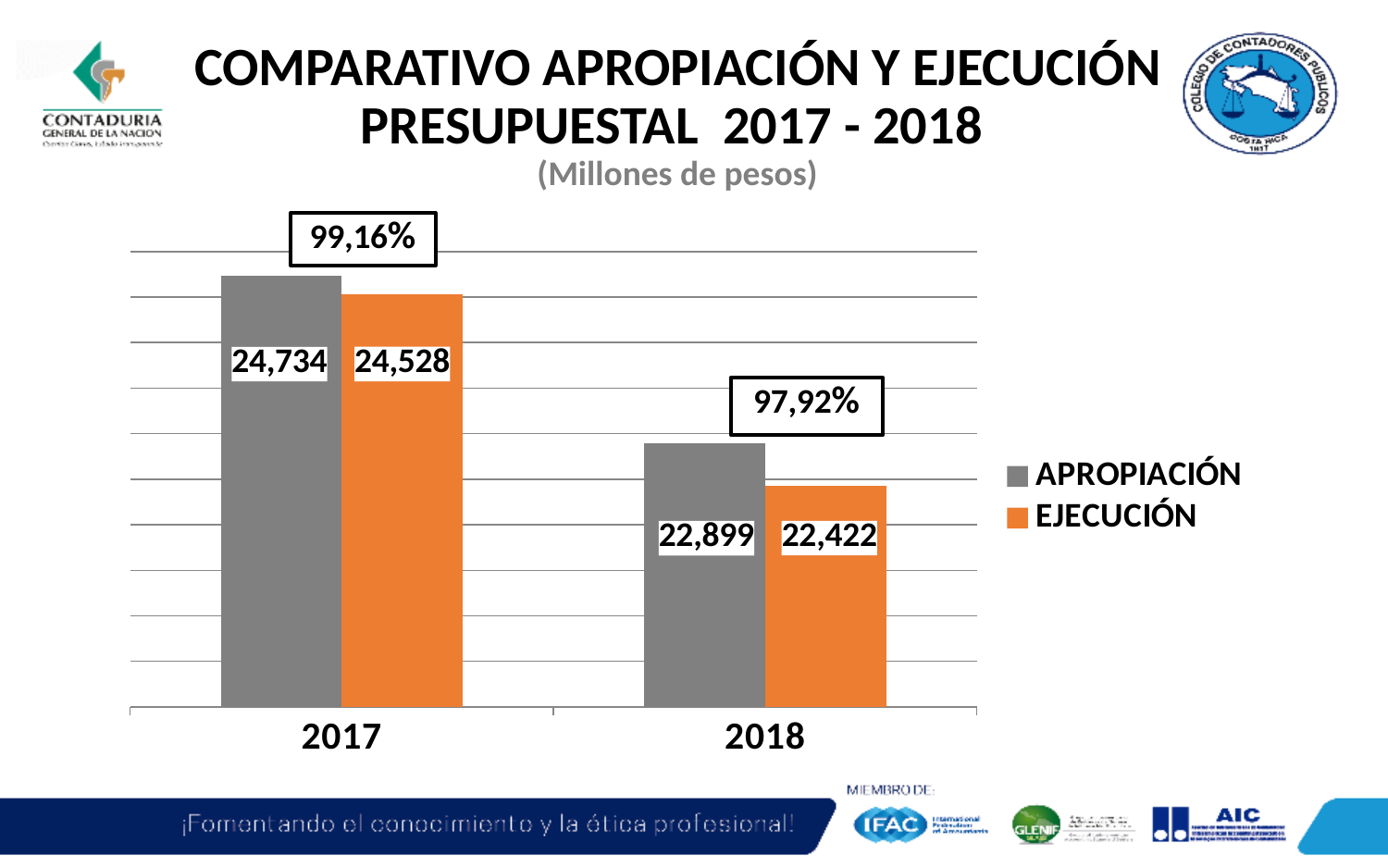
Is the EJECUCIÓN value for 2017 larger or smaller than the APROPIACIÓN value for 2018? larger Which year has the higher APROPIACIÓN value? 2017 What percentage is shown above the 2018 bars? 97,92% What is the difference between APROPIACIÓN and EJECUCIÓN in 2017? 206 How many series does the legend list? 2 What is the difference between APROPIACIÓN and EJECUCIÓN in 2018? 477 What percentage is shown above the 2017 bars? 99,16% What kind of chart is shown on the slide? bar chart What is the APROPIACIÓN value for 2017? 24,734 What is the EJECUCIÓN value for 2018? 22,422 What is the EJECUCIÓN value for 2017? 24,528 What is the APROPIACIÓN value for 2018? 22,899